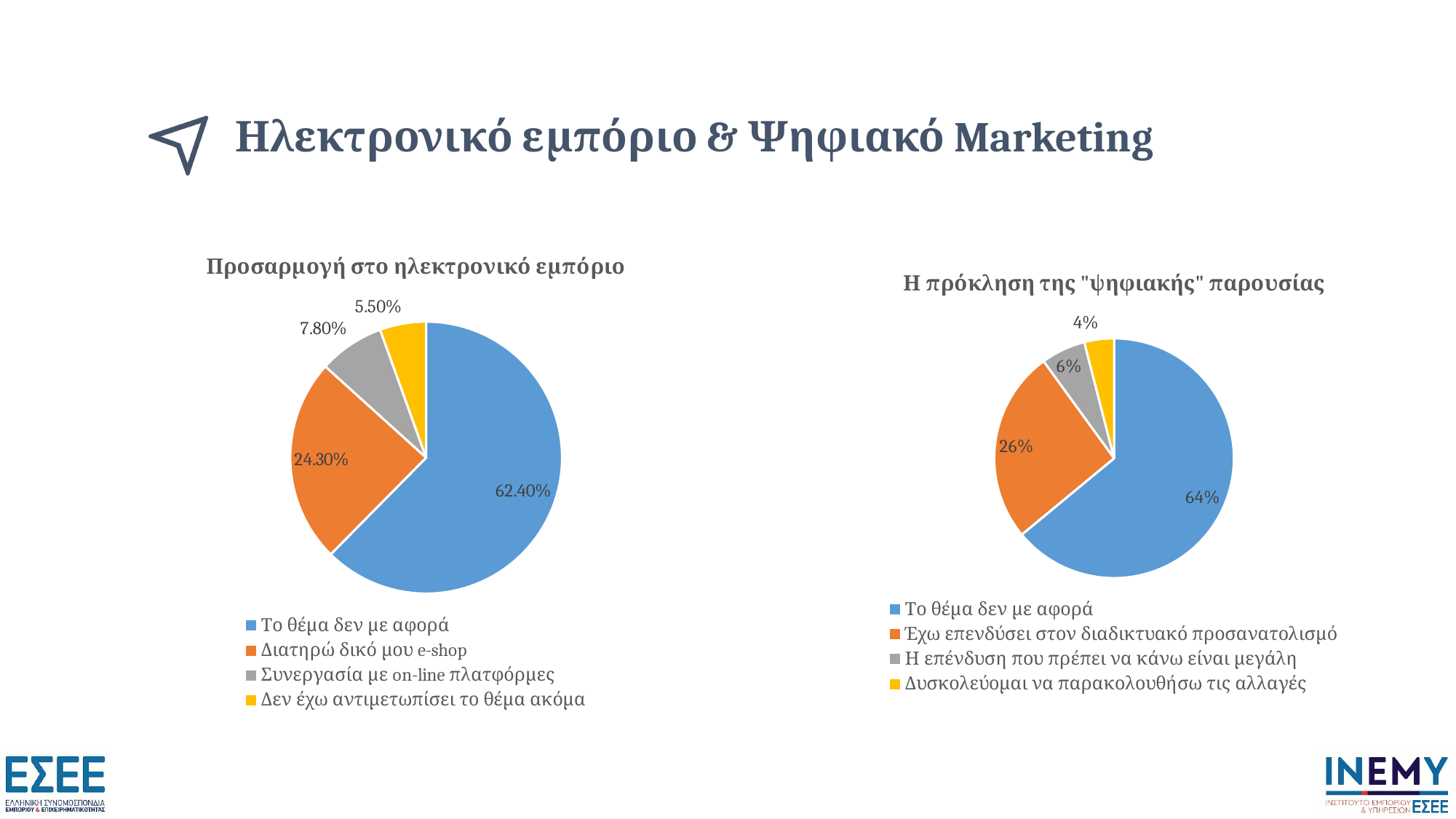
In the chart titled "Η πρόκληση της "ψηφιακής" παρουσίας", what is the value for "Δυσκολεύομαι να παρακολουθήσω τις αλλαγές"? 4% In the chart titled "Η πρόκληση της "ψηφιακής" παρουσίας", which category has the largest share? Το θέμα δεν με αφορά In the chart titled "Η πρόκληση της "ψηφιακής" παρουσίας", which is larger: "Η επένδυση που πρέπει να κάνω είναι μεγάλη" or "Δυσκολεύομαι να παρακολουθήσω τις αλλαγές"? Η επένδυση που πρέπει να κάνω είναι μεγάλη In the chart titled "Προσαρμογή στο ηλεκτρονικό εμπόριο", which category has the largest share? Το θέμα δεν με αφορά In the chart titled "Προσαρμογή στο ηλεκτρονικό εμπόριο", which category has the smallest share? Δεν έχω αντιμετωπίσει το θέμα ακόμα In the chart titled "Η πρόκληση της "ψηφιακής" παρουσίας", what is the value for "Έχω επενδύσει στον διαδικτυακό προσανατολισμό"? 26% In the chart titled "Προσαρμογή στο ηλεκτρονικό εμπόριο", what is the difference between "Το θέμα δεν με αφορά" and "Διατηρώ δικό μου e-shop"? 38.10% In the chart titled "Η πρόκληση της "ψηφιακής" παρουσίας", what colour is the slice for "Έχω επενδύσει στον διαδικτυακό προσανατολισμό"? Orange In the chart titled "Προσαρμογή στο ηλεκτρονικό εμπόριο", what is the value for "Συνεργασία με on-line πλατφόρμες"? 7.80% In the chart titled "Η πρόκληση της "ψηφιακής" παρουσίας", how many categories are shown? 4 What type of chart is the chart titled "Προσαρμογή στο ηλεκτρονικό εμπόριο"? Pie chart In the chart titled "Προσαρμογή στο ηλεκτρονικό εμπόριο", what is the value for "Διατηρώ δικό μου e-shop"? 24.30%